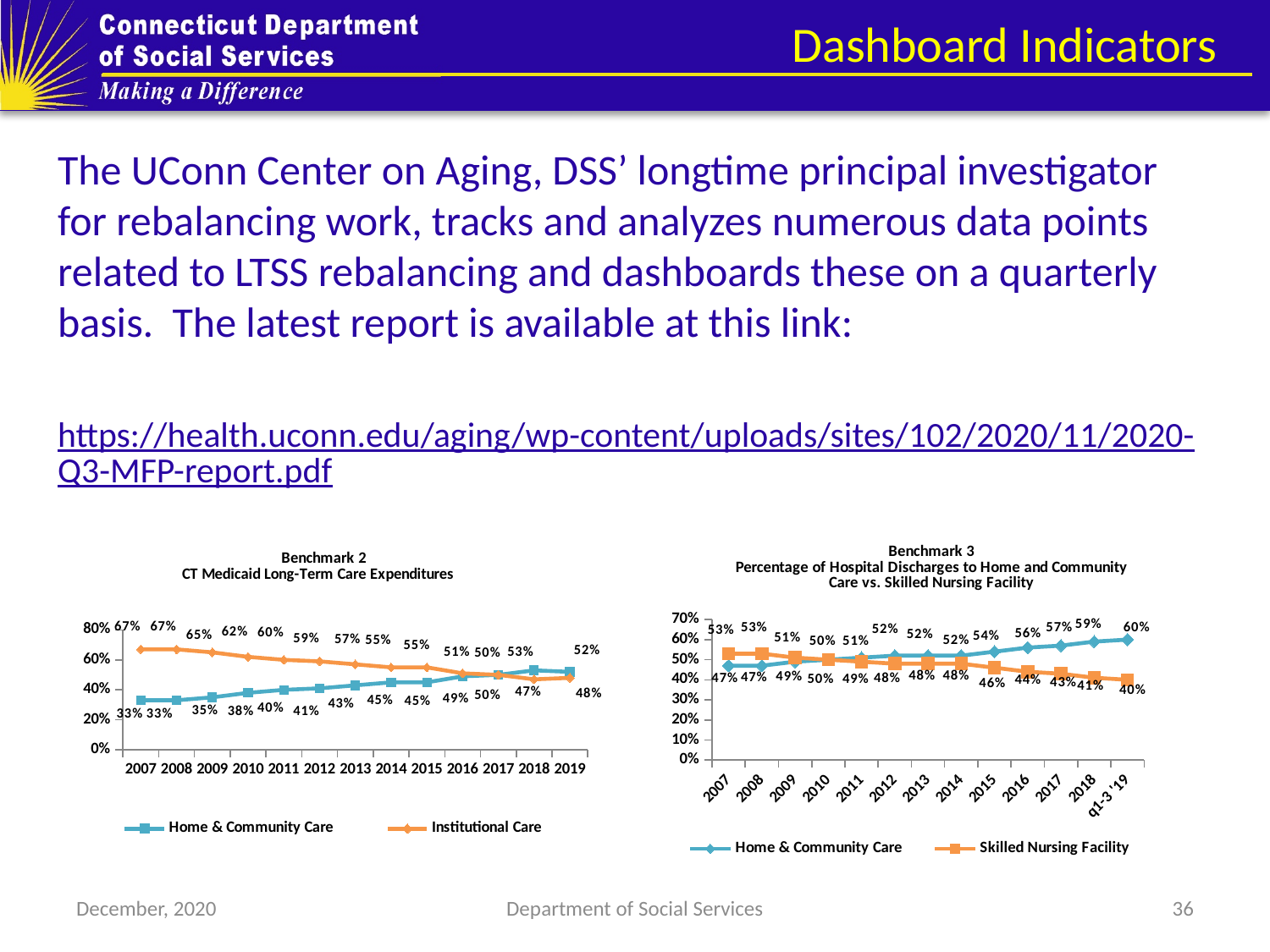
What kind of chart is Benchmark 2 (CT Medicaid Long-Term Care Expenditures)? Line chart In the Benchmark 2 chart, what is the Home & Community Care value for 2014? 45% In the Benchmark 2 chart, what is the Institutional Care value for 2007? 67% In the Benchmark 2 chart, what is the difference between Institutional Care and Home & Community Care in 2007? 34 percentage points In the Benchmark 3 chart, in which period is the Home & Community Care value highest? q1-3 '19 How many years are plotted on the x axis of the Benchmark 2 chart? 13 In the Benchmark 3 chart, what is the Skilled Nursing Facility value for 2016? 44% How many series does the legend of the Benchmark 3 chart list? 2 In the Benchmark 3 chart, what is the difference between Home & Community Care and Skilled Nursing Facility in 2015? 8 percentage points In the Benchmark 2 chart, does the Institutional Care line generally rise or fall from 2007 to 2017? Fall In the Benchmark 3 chart, which series has the larger value in 2007, Home & Community Care or Skilled Nursing Facility? Skilled Nursing Facility In the Benchmark 3 chart, what is the Home & Community Care value for q1-3 '19? 60%